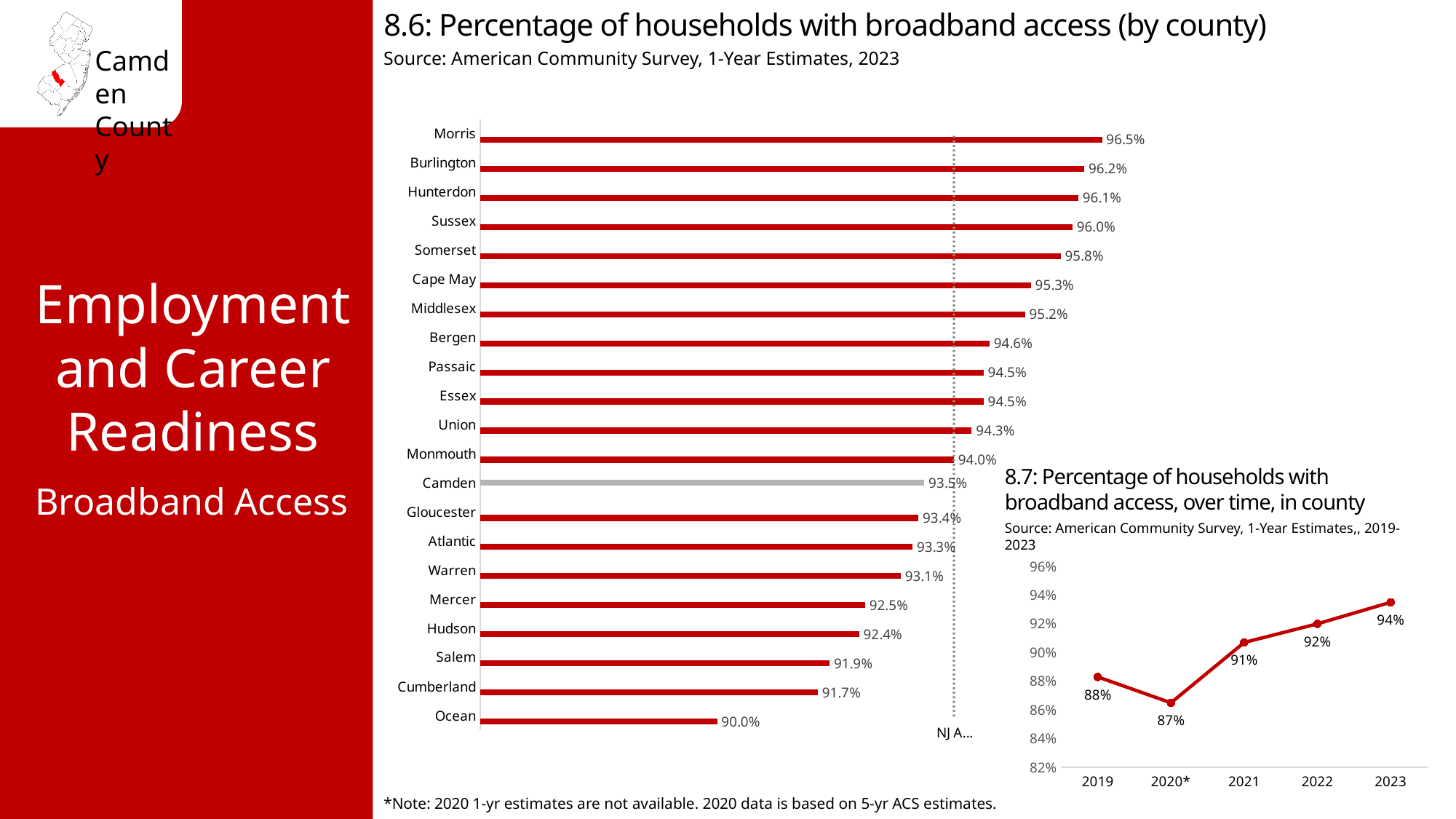
In chart 8.6, which county has a higher value, Mercer or Hudson? Mercer In chart 8.7, what is the difference in percentage points between 2023 and 2019? 6 In chart 8.7, what was the percentage of households with broadband access in 2020? 87% In chart 8.7, how many years are plotted? 5 In chart 8.6, which county has the highest percentage of households with broadband access? Morris In chart 8.7, which year has the highest value? 2023 In chart 8.6, which county has the lowest percentage of households with broadband access? Ocean What kind of chart is chart 8.6? Bar chart In chart 8.6, what is the value for Cumberland? 91.7% In chart 8.6, what is the difference in percentage points between Morris and Ocean? 6.5 In chart 8.6, how many counties are shown? 21 In chart 8.6, what percentage of households in Camden County have broadband access? 93.5%